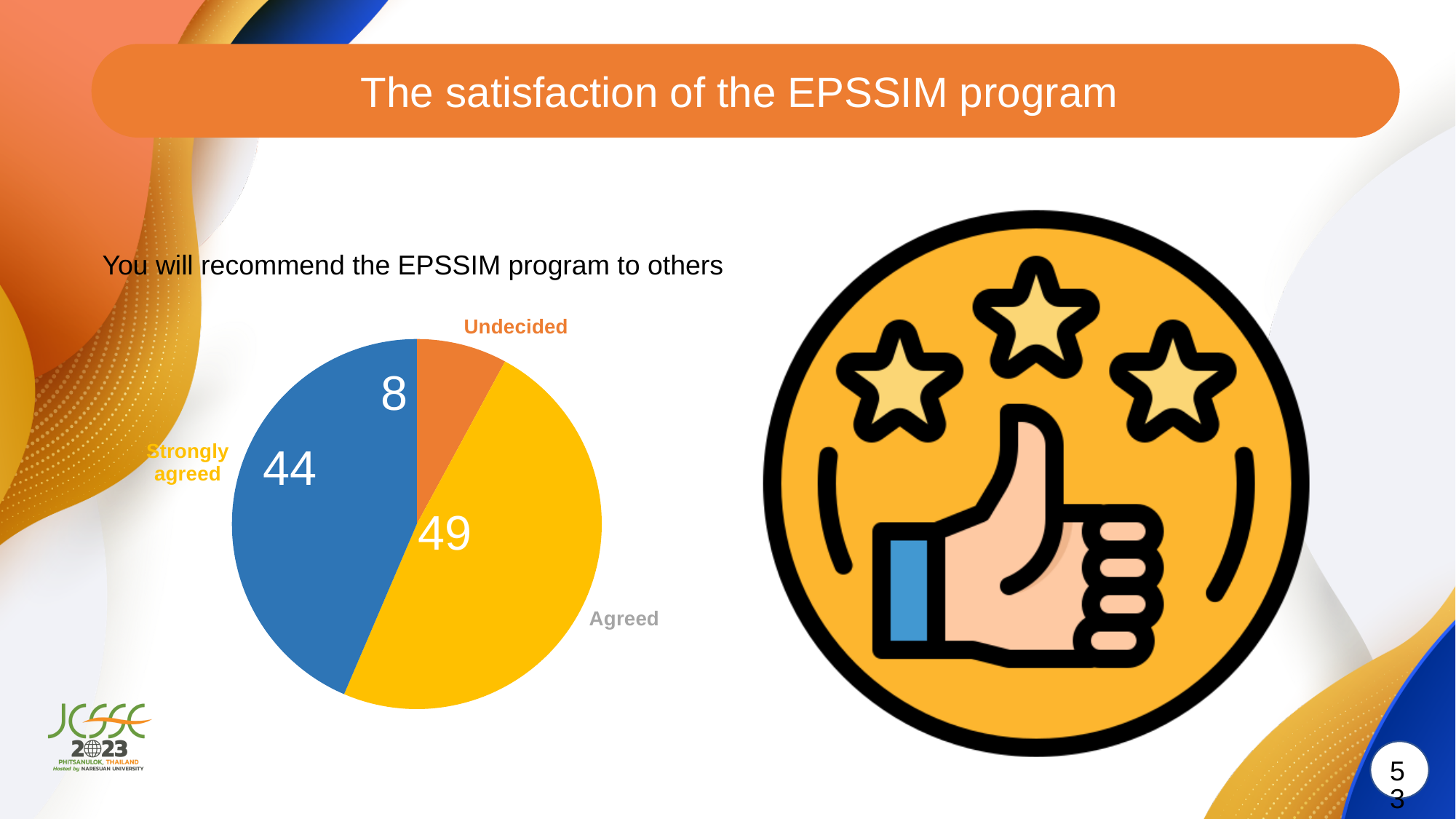
Which category has the smallest slice in the pie chart? Undecided Which category has the largest slice in the pie chart? Agreed What kind of chart is shown on the slide? Pie chart What colour is the Strongly agreed slice in the pie chart? Blue What value is shown for the Undecided slice of the pie chart? 8 What value is shown for the Agreed slice of the pie chart? 49 What is the difference between the Agreed value and the Undecided value? 41 What value is shown for the Strongly agreed slice of the pie chart? 44 What is the difference between the Agreed value and the Strongly agreed value? 5 Which is larger, the value for Strongly agreed or the value for Undecided? Strongly agreed What statement does the pie chart report responses to? You will recommend the EPSSIM program to others How many categories are shown in the pie chart? 3